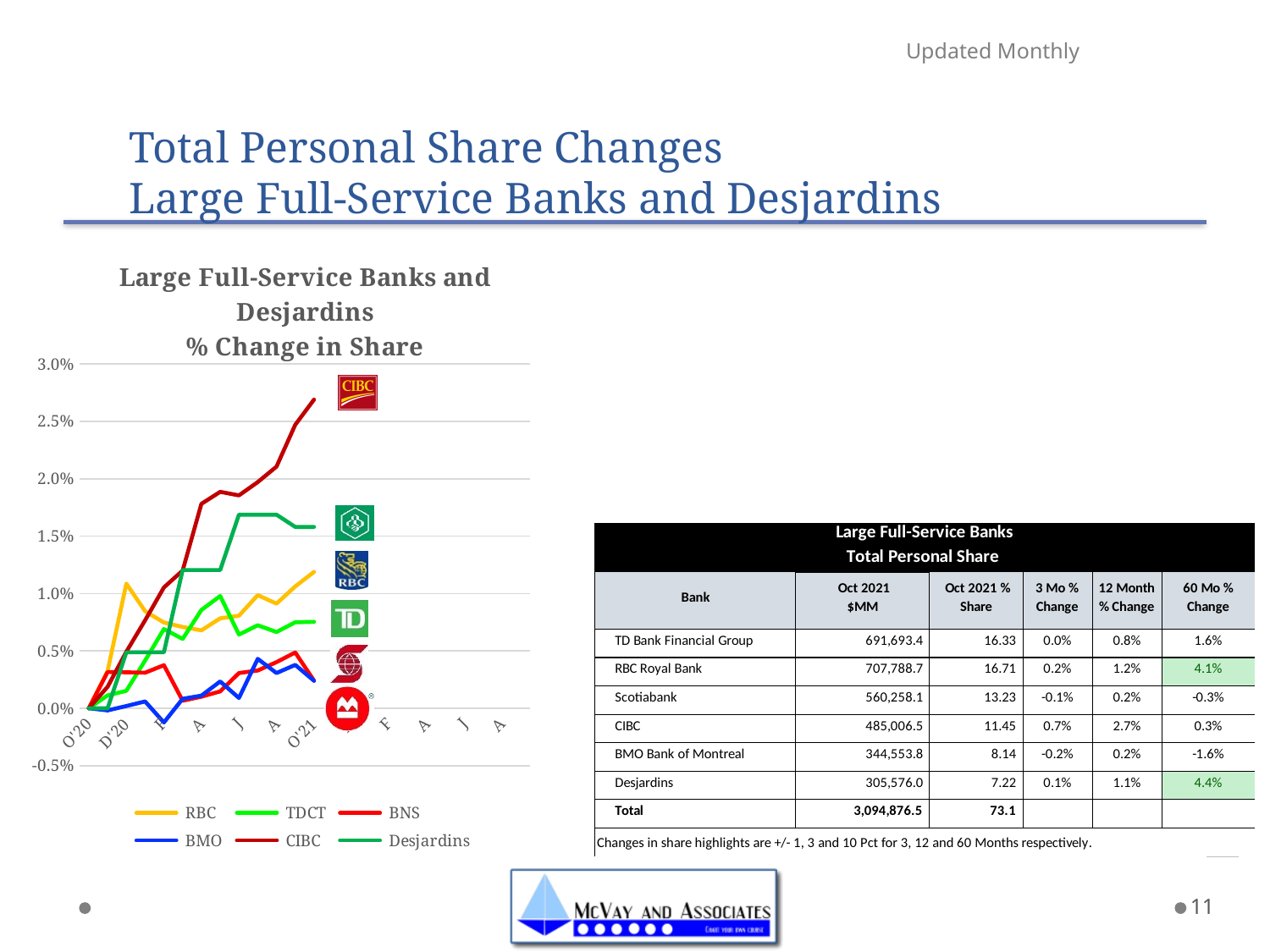
Is the final value for Desjardins greater or less than 1.0%? greater What value do all the series start at in O'20? 0.0% How many series does the chart legend list? 6 Does the CIBC line rise or fall overall from O'20 to the end of the series? rises Is the final value for TDCT greater or less than 1.0%? less Which series has the highest value at the last plotted point on the chart? CIBC What is the highest value shown on the chart's y axis? 3.0% Is the final value for RBC greater or less than 1.5%? less What type of chart is shown on the slide? line chart What is the title of the chart? Large Full-Service Banks and Desjardins % Change in Share At the last plotted point, which is higher, CIBC or TDCT? CIBC